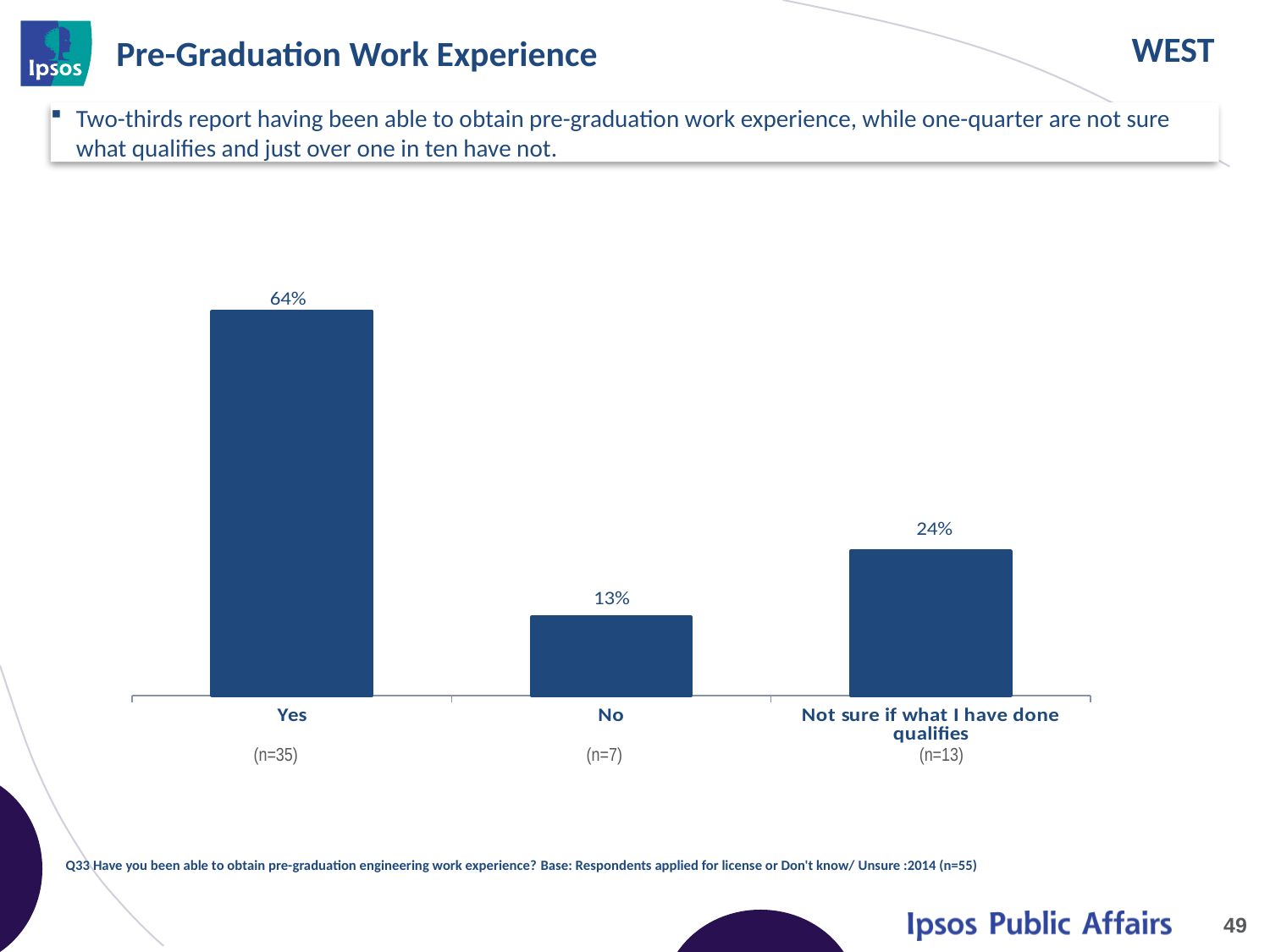
What is the difference in percentage points between "Not sure if what I have done qualifies" and "No"? 11 What is the title of the slide containing the chart? Pre-Graduation Work Experience Which response category has the highest percentage? Yes Which response category has the lowest percentage? No What percentage of respondents answered "Yes" to having obtained pre-graduation work experience? 64% What percentage of respondents answered "Not sure if what I have done qualifies"? 24% What is the difference in percentage points between "Yes" and "No"? 51 What percentage of respondents answered "No"? 13% Which is larger, the percentage for "No" or for "Not sure if what I have done qualifies"? Not sure if what I have done qualifies What is the sample size (n) shown under the "Yes" category? (n=35) How many response categories are shown in the chart? 3 What type of chart is shown on the slide? Bar chart